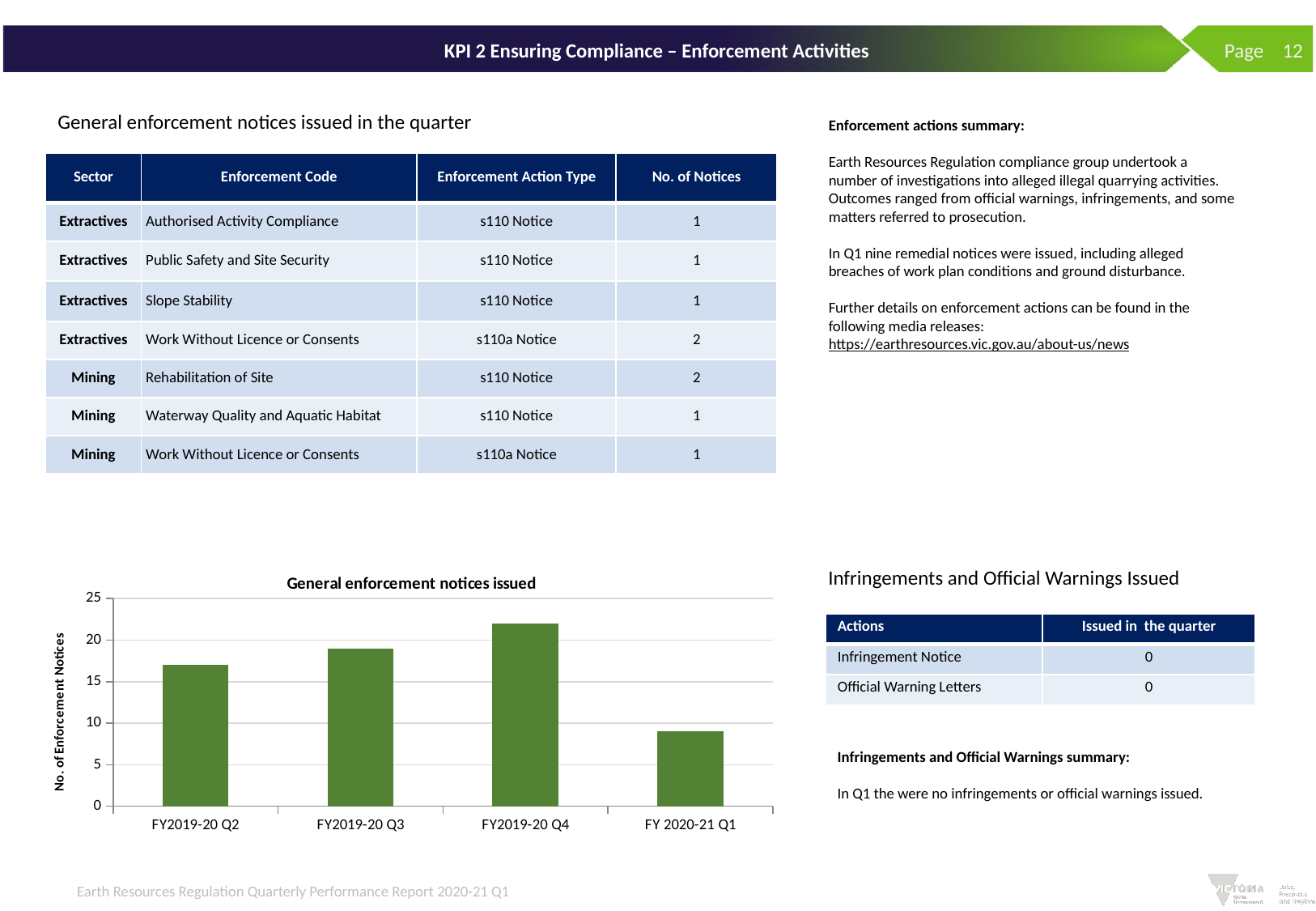
Which is larger, the value for FY2019-20 Q4 or the value for FY 2020-21 Q1? FY2019-20 Q4 How many quarters are plotted in the General enforcement notices issued chart? 4 Is the value for FY2019-20 Q4 greater or less than 20? greater Is the value for FY2019-20 Q3 greater or less than 20? less Is the value for FY 2020-21 Q1 greater or less than 10? less What is the label on the vertical axis of the chart? No. of Enforcement Notices Which quarter has the highest number of enforcement notices in the chart? FY2019-20 Q4 Do the values rise or fall from FY2019-20 Q4 to FY 2020-21 Q1? fall What kind of chart is shown on the slide? bar chart Which quarter has the lowest number of enforcement notices in the chart? FY 2020-21 Q1 What is the title of the chart? General enforcement notices issued